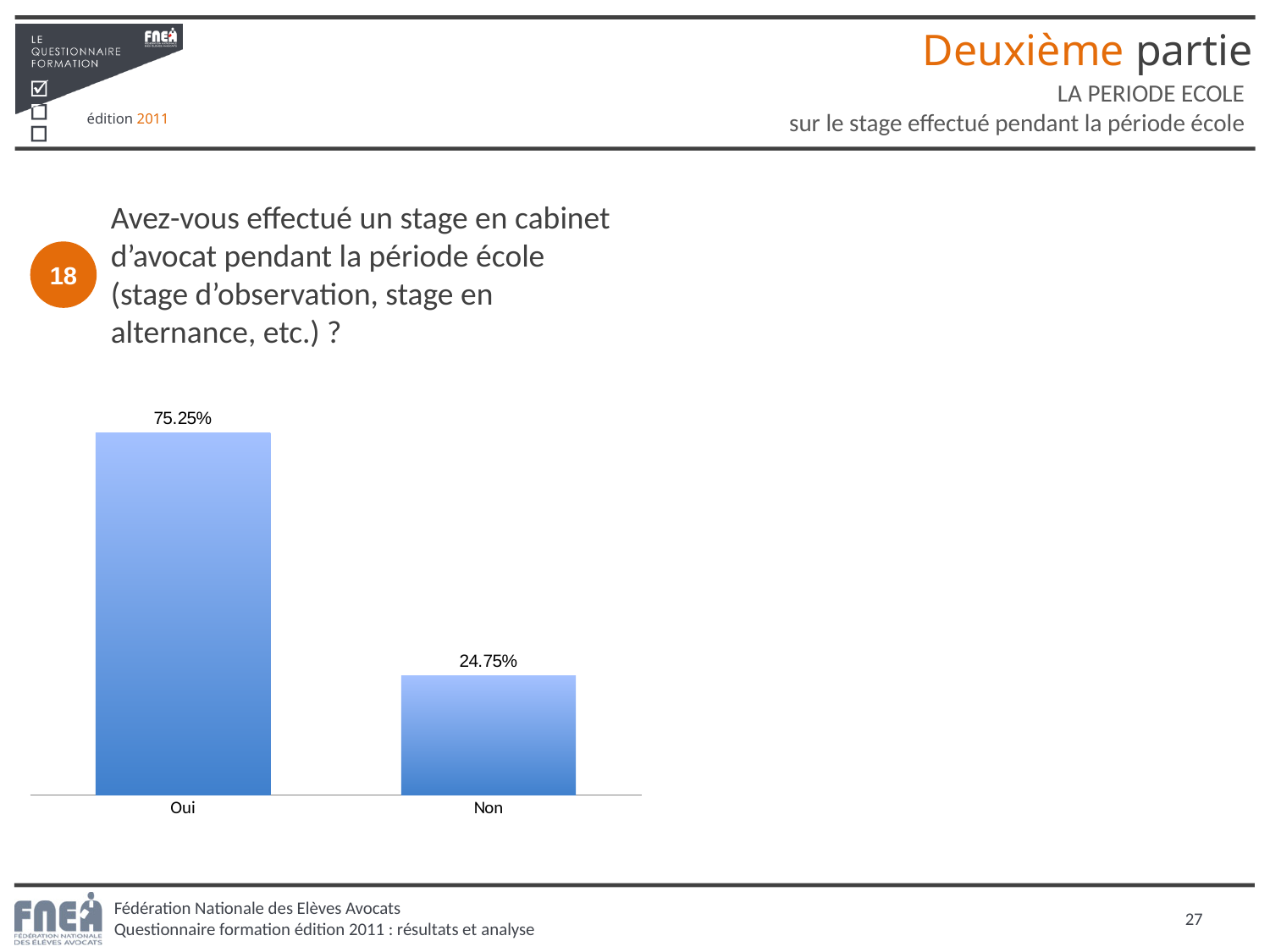
What are the category labels on the x axis of the chart? Oui, Non How many categories are shown on the chart? 2 What is the total of the two values shown on the chart? 100.00% Which is larger, the value for Oui or the value for Non? Oui What is the value for Non? 24.75% What is the difference between the values for Oui and Non? 50.50% Which category has the lowest value? Non Which category has the highest value? Oui What colour are the bars in the chart? Blue What kind of chart is shown on the slide? Bar chart What is the value for Oui? 75.25%